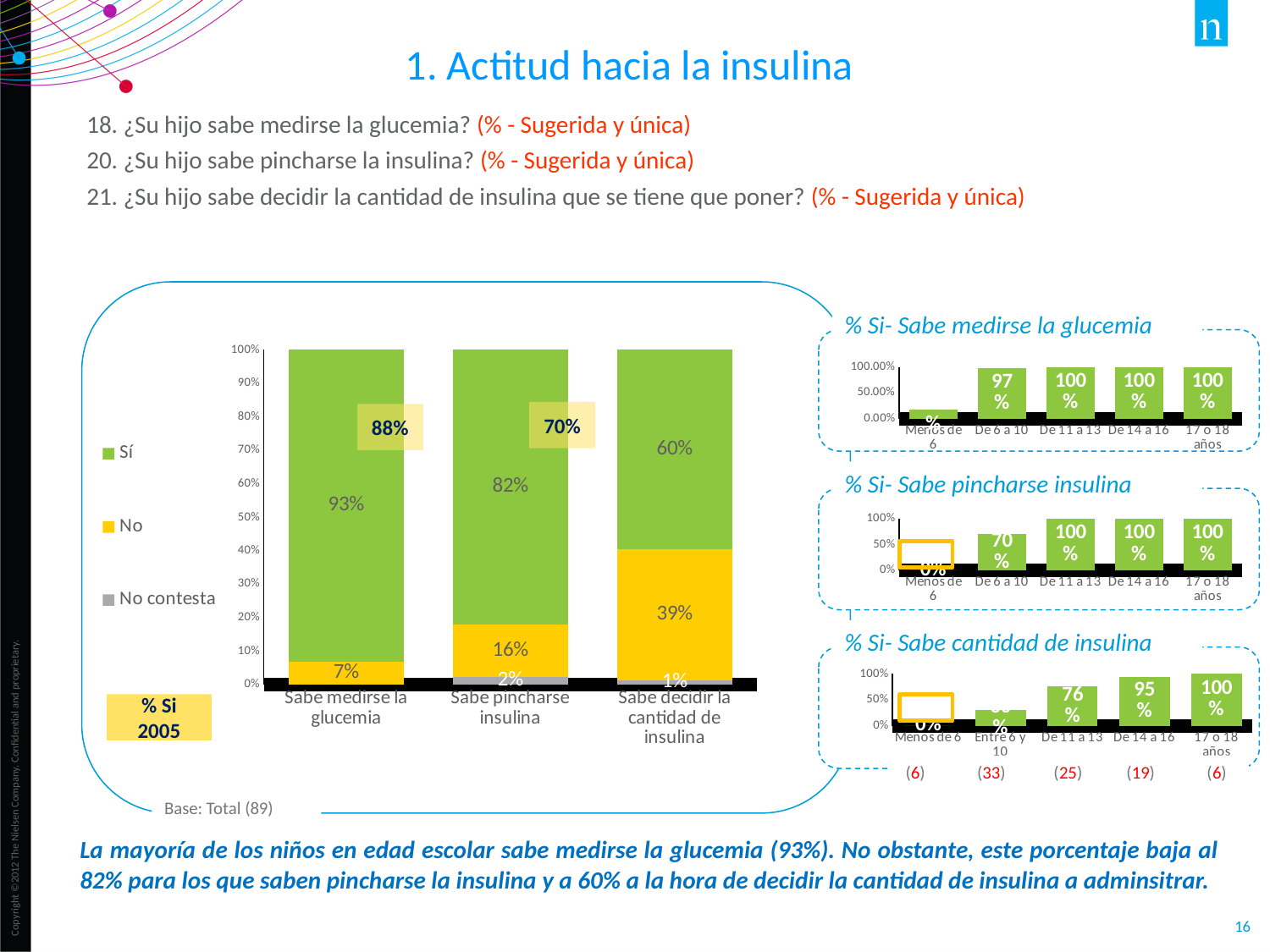
In the main stacked bar chart, what percentage answered 'No contesta' for 'Sabe pincharse insulina'? 2% In the chart '% Si- Sabe pincharse insulina', what is the value for 'De 6 a 10'? 70% In the main stacked bar chart, what percentage answered 'Sí' for 'Sabe medirse la glucemia'? 93% In the chart '% Si- Sabe cantidad de insulina', what is the value for 'De 14 a 16'? 95% In the chart '% Si- Sabe medirse la glucemia', what is the value for 'De 6 a 10'? 97% In the main stacked bar chart, what is the difference between the 'Sí' percentages for 'Sabe medirse la glucemia' and 'Sabe pincharse insulina'? 11% In the main stacked bar chart, which category has the lowest 'Sí' percentage? Sabe decidir la cantidad de insulina In the main stacked bar chart, what percentage answered 'No' for 'Sabe decidir la cantidad de insulina'? 39% In the main stacked bar chart, is the 'No' percentage for 'Sabe pincharse insulina' larger or smaller than for 'Sabe decidir la cantidad de insulina'? Smaller What type of chart is the main chart on the left of the slide? Stacked bar chart In the chart '% Si- Sabe cantidad de insulina', do the values rise or fall from 'Menos de 6' to '17 o 18 años'? Rise How many series does the legend of the main stacked bar chart list? 3